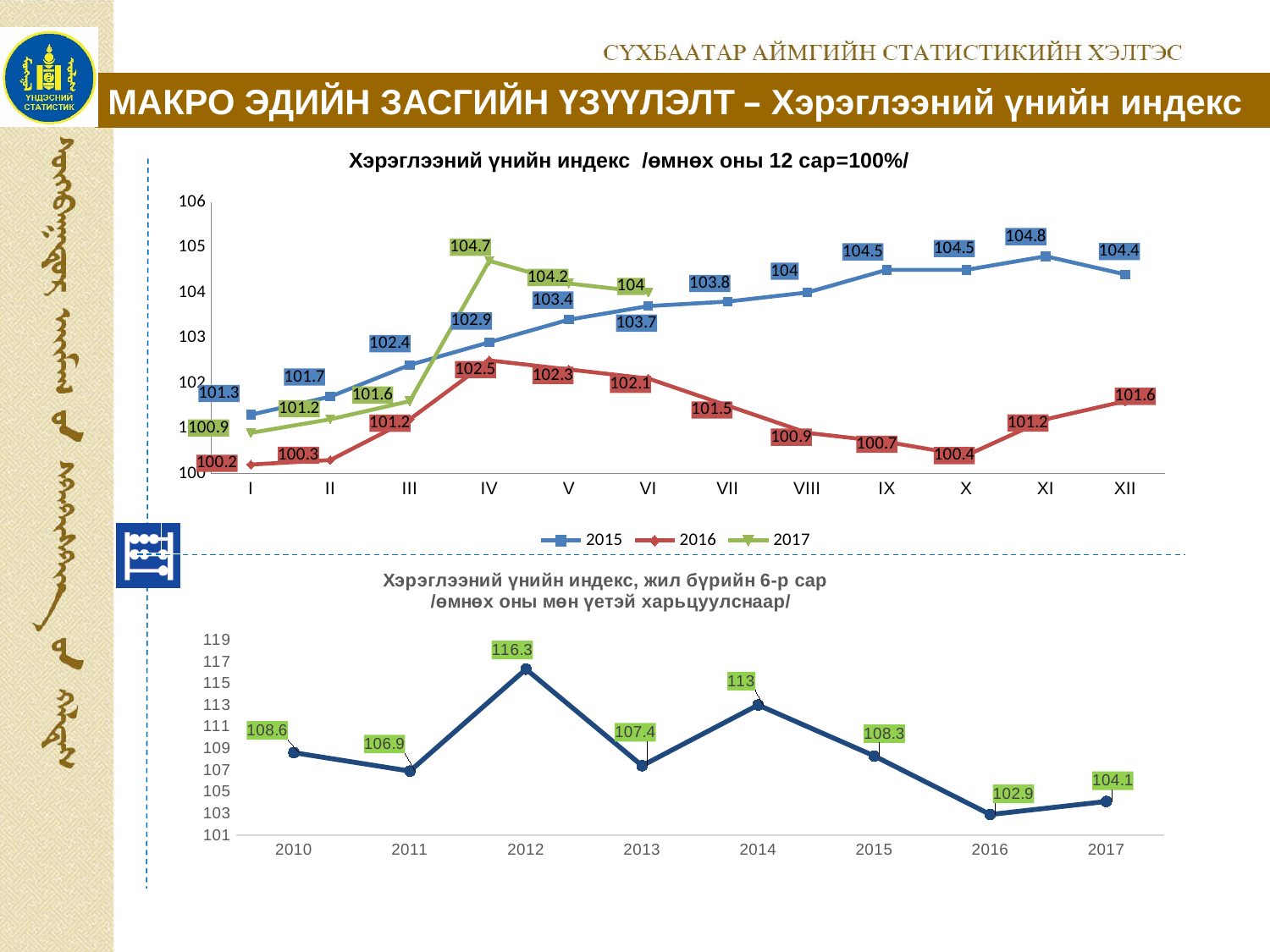
In the top chart, what is the difference between the 2017 value and the 2015 value in month IV? 1.8 In the top chart, what is the value for the 2017 series in month VI? 104 In the top chart, which is larger in month VIII: the 2015 value or the 2016 value? 2015 In the top chart (Хэрэглээний үнийн индекс /өмнөх оны 12 сар=100%/), what is the value for the 2015 series in month XI? 104.8 How many series does the legend of the top chart list? 3 In the bottom chart, what is the difference between the values for 2014 and 2015? 4.7 What type of chart is the bottom chart? Line chart In the bottom chart, which year has the lowest value? 2016 In the top chart, which month has the lowest value for the 2016 series? I How many years are plotted in the bottom chart? 8 In the top chart, what is the value for the 2016 series in month IV? 102.5 In the bottom chart (Хэрэглээний үнийн индекс, жил бүрийн 6-р сар), what is the value for 2012? 116.3